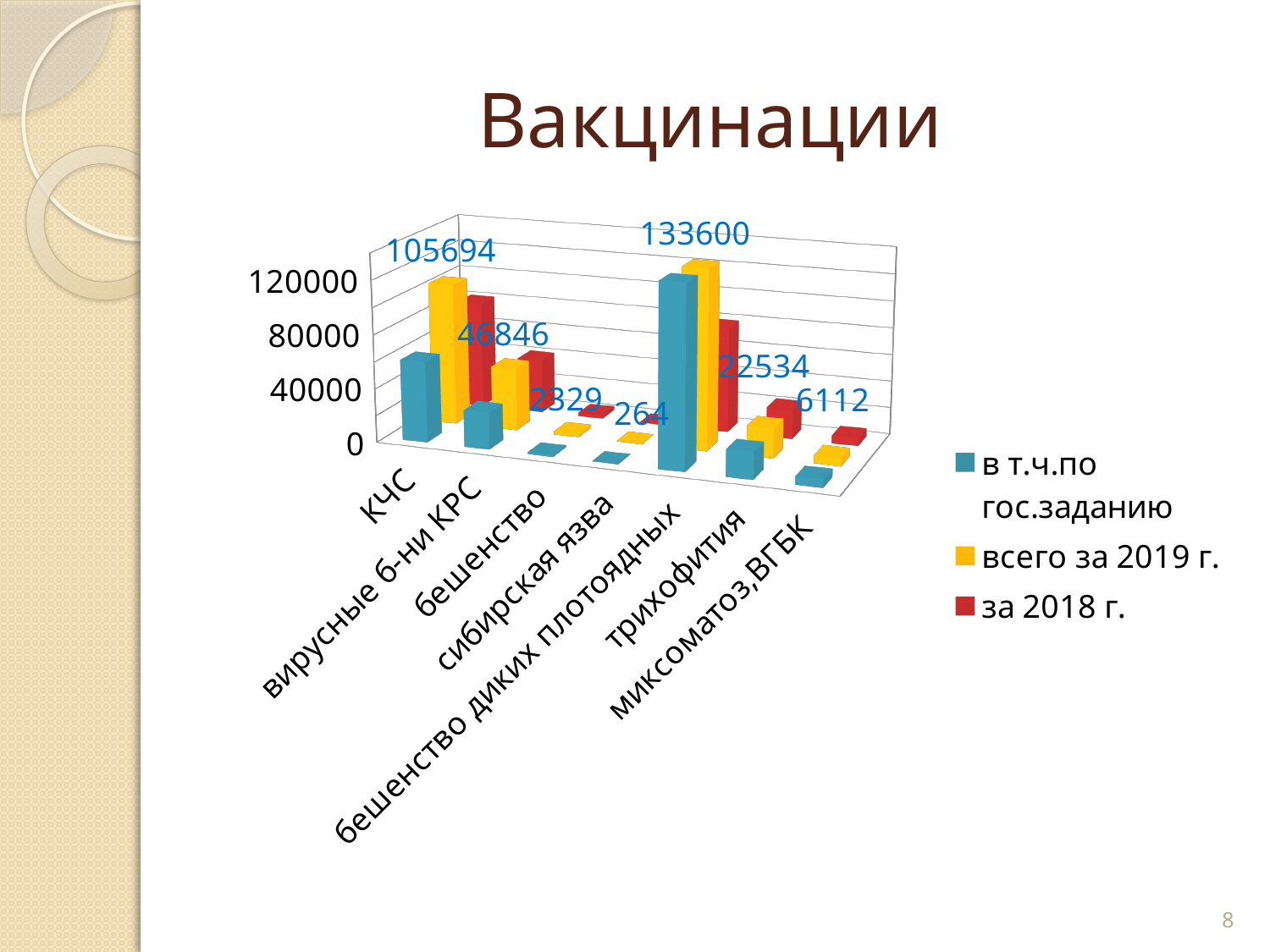
Which category has the lowest value in the series 'всего за 2019 г.'? сибирская язва In the series 'всего за 2019 г.', which is larger: КЧС or 'вирусные б-ни КРС'? КЧС What is the difference between the 'всего за 2019 г.' values for 'бешенство диких плотоядных' and КЧС? 27906 What is the title of the chart? Вакцинации How many categories are shown on the x axis of the chart? 7 What is the value for 'сибирская язва' in the series 'всего за 2019 г.'? 264 What is the value for 'трихофития' in the series 'всего за 2019 г.'? 22534 What is the value for КЧС in the series 'всего за 2019 г.'? 105694 What is the value for 'бешенство диких плотоядных' in the series 'всего за 2019 г.'? 133600 Which category has the highest value in the series 'всего за 2019 г.'? бешенство диких плотоядных How many series does the legend list? 3 What kind of chart is shown on the slide? bar chart